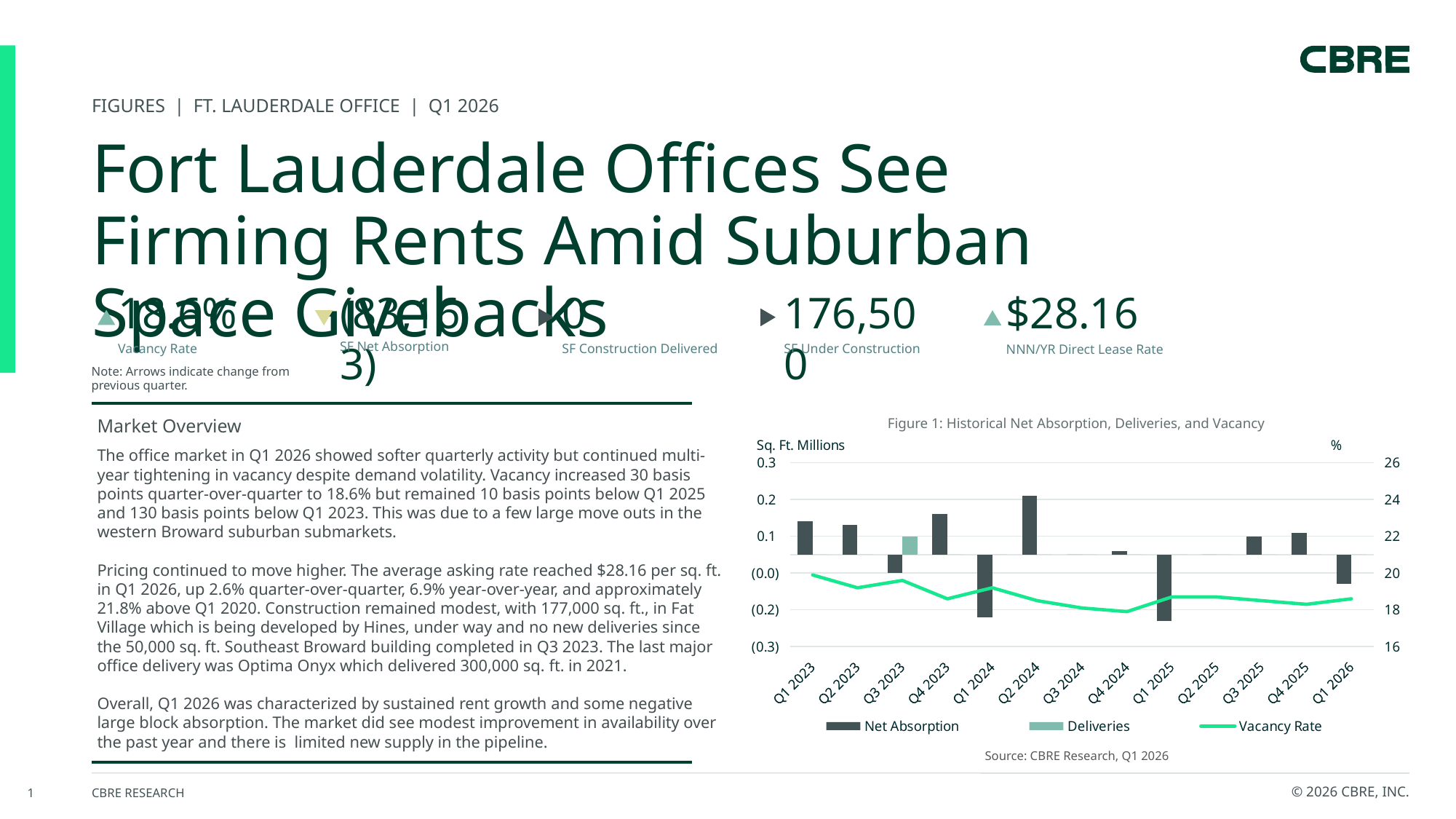
In Figure 1, is the Vacancy Rate for Q1 2023 greater or less than 18? greater In Figure 1, in which quarter does a Deliveries bar appear? Q3 2023 How many series does the legend of Figure 1 list? 3 What type of chart is Figure 1? Combination bar and line chart In Figure 1, does the Vacancy Rate line generally rise or fall from Q1 2023 to Q1 2026? fall In Figure 1, which quarter has the highest Net Absorption bar? Q2 2024 In Figure 1, which is larger: the Net Absorption for Q4 2023 or for Q3 2025? Q4 2023 What is the unit label on the left axis of Figure 1? Sq. Ft. Millions How many quarters are shown on the x axis of Figure 1? 13 In Figure 1, is the Vacancy Rate for Q4 2024 greater or less than 19? less